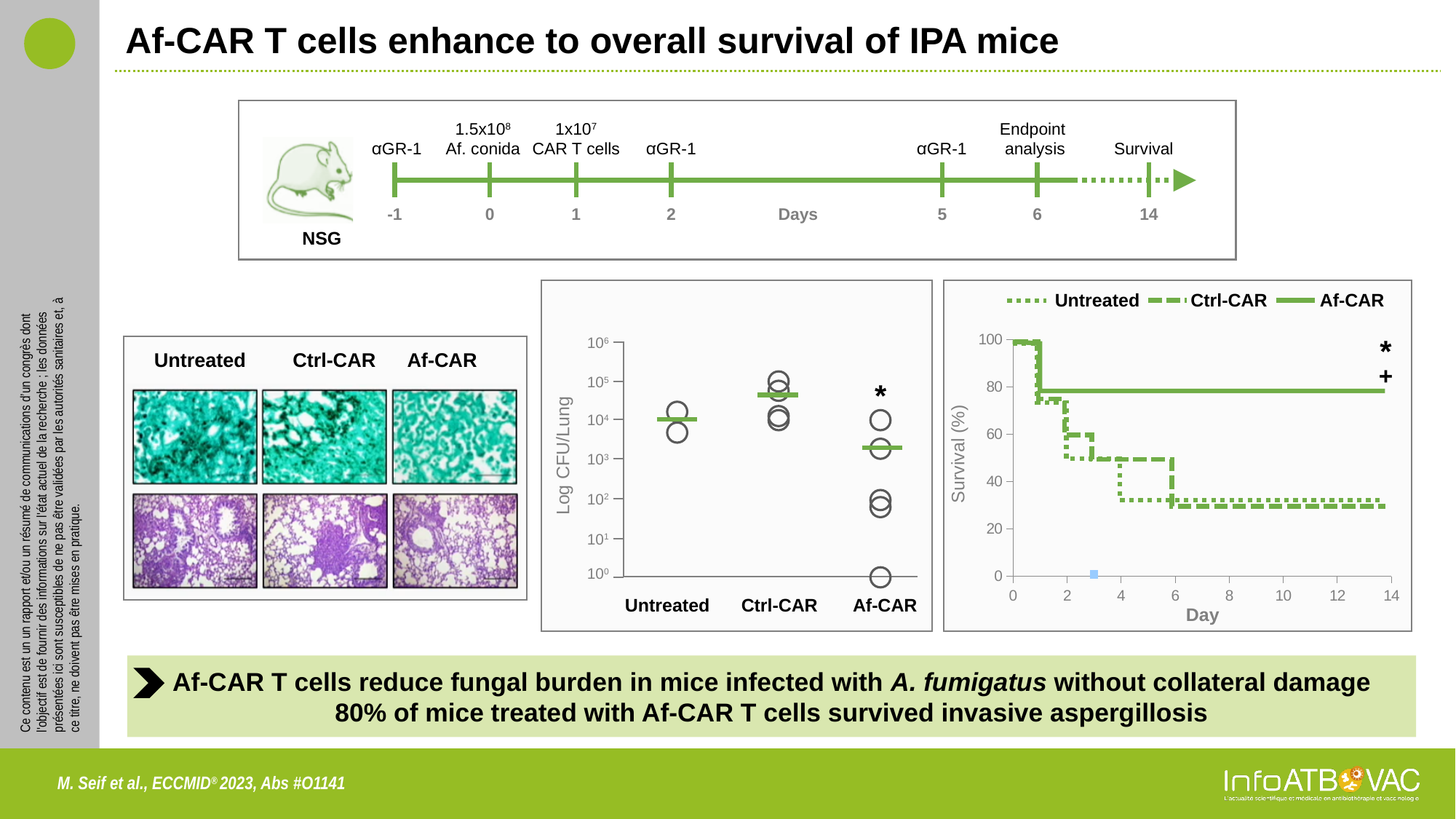
In the survival chart, which group has the highest survival at day 14? Af-CAR In the Log CFU/Lung chart, which group is marked with an asterisk? Af-CAR In the Log CFU/Lung chart, is the mean value for Ctrl-CAR greater or less than 10^4? greater In the survival chart, what is the survival percentage of the Af-CAR group at day 14? 80 How many series does the legend of the survival chart list? 3 In the Log CFU/Lung chart, is the mean value for Af-CAR greater or less than 10^4? less In the Log CFU/Lung chart, which group has the highest mean fungal burden? Ctrl-CAR In the Log CFU/Lung chart, which group has the lowest mean fungal burden? Af-CAR What kind of chart is the survival chart on the right? line chart In the survival chart, what is the label of the x axis? Day In the Log CFU/Lung chart, how many treatment groups are shown on the x axis? 3 In the survival chart, is the survival of the Untreated group at day 14 greater or less than 40? less